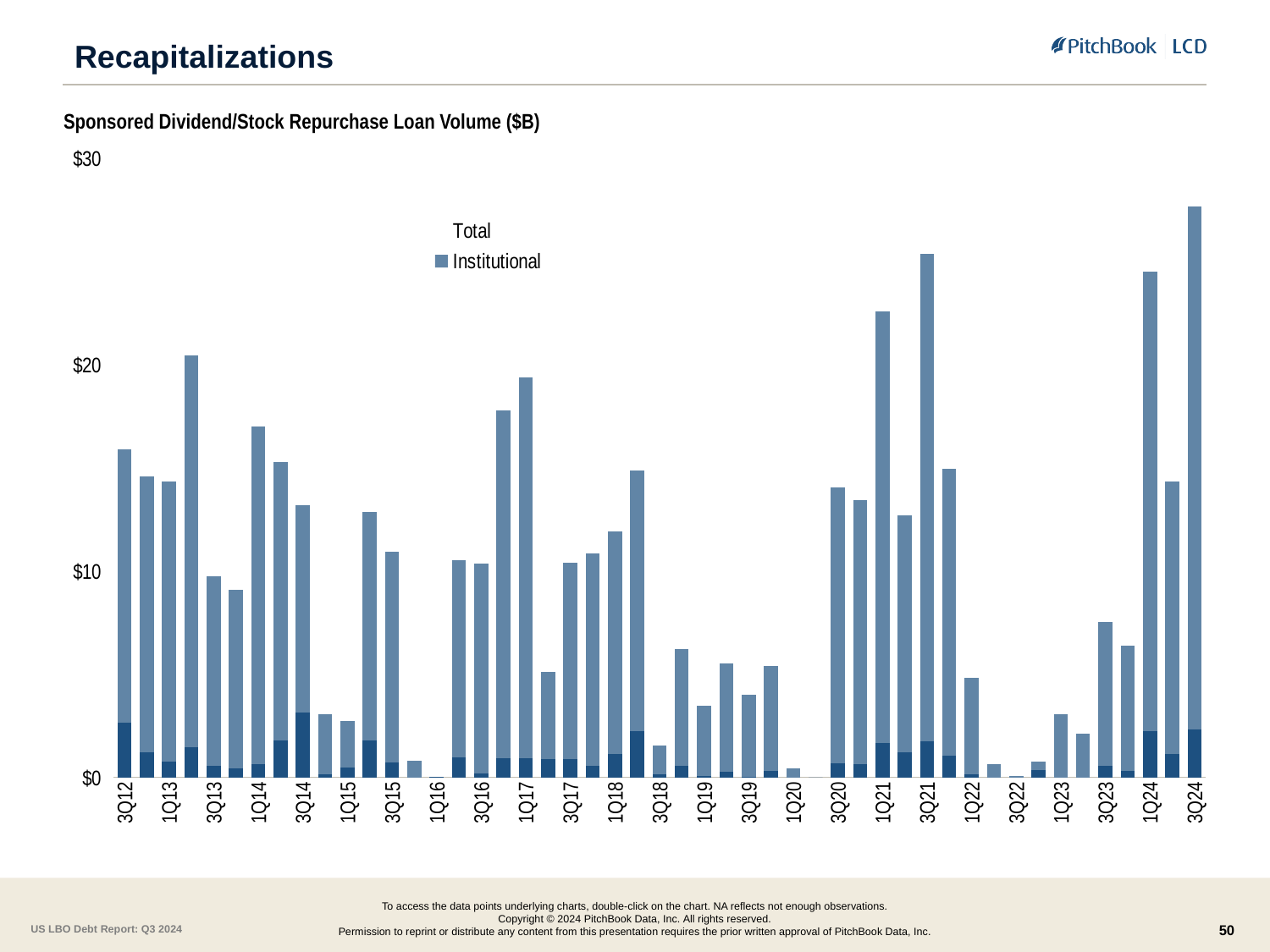
Which quarter has the highest total loan volume? 3Q24 What is the title of the chart? Sponsored Dividend/Stock Repurchase Loan Volume ($B) What kind of chart is shown on the slide? bar chart Is the total value for 3Q21 greater or less than $20? greater Is the total value for 3Q24 greater or less than $20? greater Which quarter has the larger total, 1Q24 or 3Q24? 3Q24 How many series does the legend list? 2 Which quarter has the larger total, 1Q14 or 3Q14? 1Q14 Is the total value for 3Q23 greater or less than $10? less What are the two series named in the legend? Total and Institutional